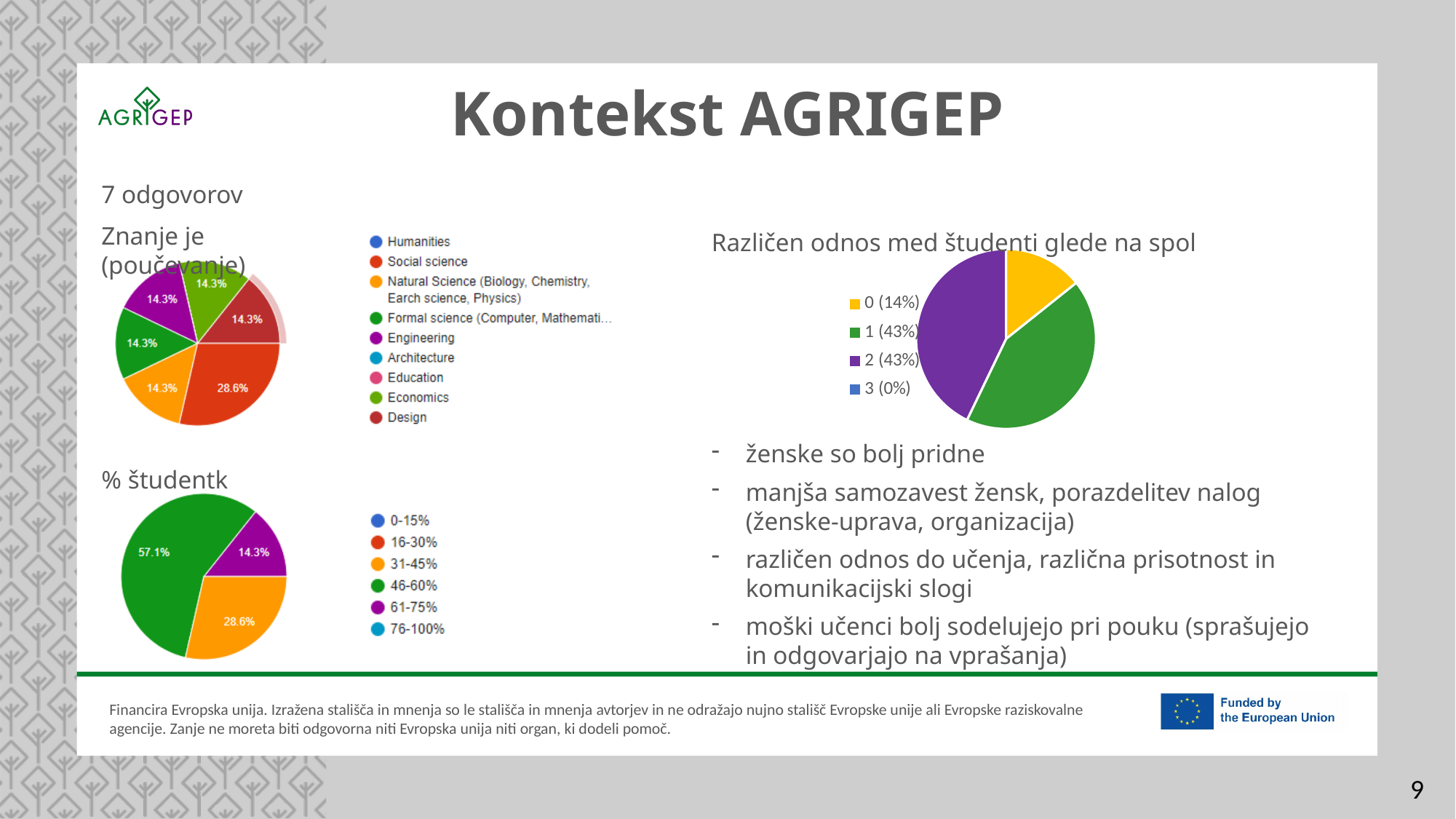
In the 'Različen odnos med študenti glede na spol' pie chart, which is larger: category 0 or category 2? Category 2 How many entries does the legend of the 'Znanje je (poučevanje)' pie chart list? 9 In the '% študentk' pie chart, which category has the smallest visible slice? 61-75% In the 'Znanje je (poučevanje)' pie chart, what share does Social science have? 28.6% How many entries does the legend of the '% študentk' pie chart list? 6 In the 'Različen odnos med študenti glede na spol' pie chart, what share does category 1 have? 43% What kind of chart is the 'Znanje je (poučevanje)' chart? Pie chart In the '% študentk' pie chart, what share does the 46-60% category have? 57.1% In the '% študentk' pie chart, what share does the 31-45% category have? 28.6% In the 'Različen odnos med študenti glede na spol' pie chart, which category has the smallest share? 3 (0%) In the '% študentk' pie chart, what is the difference between the 46-60% slice and the 31-45% slice? 28.5% In the 'Znanje je (poučevanje)' pie chart, which category has the largest slice? Social science